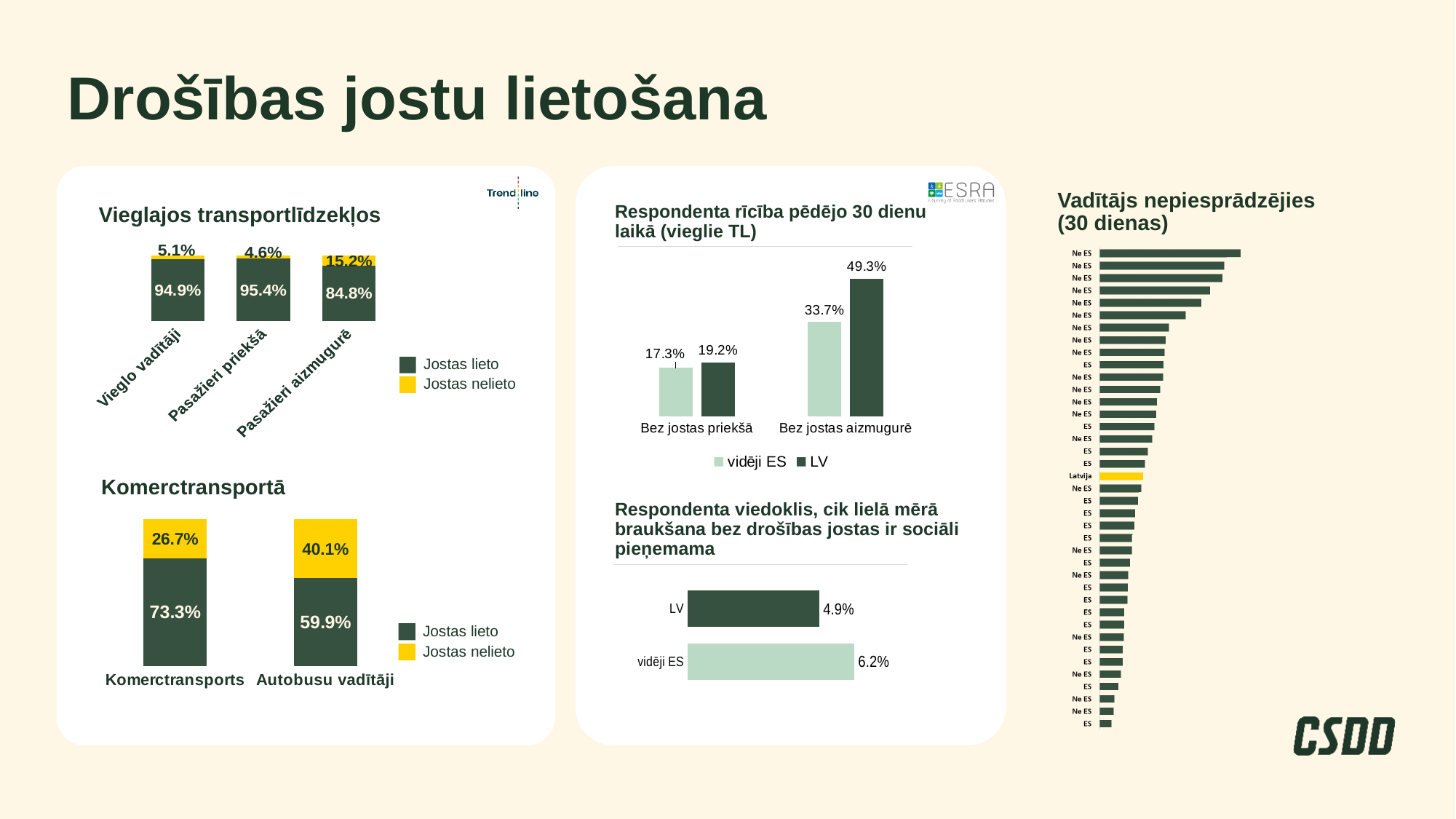
What kind of chart is 'Vadītājs nepiespradzējies (30 dienas)'? Bar chart In the 'Respondenta rīcība pēdējo 30 dienu laikā (vieglie TL)' chart, what is the LV value for Bez jostas aizmugurē? 49.3% In the 'Komerctransportā' chart, what is the 'Jostas nelieto' value for Autobusu vadītāji? 40.1% In the 'Respondenta rīcība pēdējo 30 dienu laikā (vieglie TL)' chart, what is the difference between the LV and vidēji ES values for Bez jostas aizmugurē? 15.6% In the 'Komerctransportā' chart, which category has the lower 'Jostas lieto' value? Autobusu vadītāji In the 'Respondenta viedoklis, cik lielā mērā braukšana bez drošības jostas ir sociāli pieņemama' chart, what is the value for vidēji ES? 6.2% In the 'Vieglajos transportlīdzekļos' chart, what is the 'Jostas lieto' value for Pasažieri aizmugurē? 84.8% In the 'Respondenta rīcība pēdējo 30 dienu laikā (vieglie TL)' chart, which is larger for Bez jostas priekšā: vidēji ES or LV? LV In the 'Vieglajos transportlīdzekļos' chart, which category has the highest 'Jostas nelieto' value? Pasažieri aizmugurē In the 'Respondenta rīcība pēdējo 30 dienu laikā (vieglie TL)' chart, how many series does the legend list? 2 In the 'Vieglajos transportlīdzekļos' chart, what is the difference between the 'Jostas lieto' values for Pasažieri priekšā and Vieglo vadītāji? 0.5% In the 'Komerctransportā' chart, how many categories are shown? 2